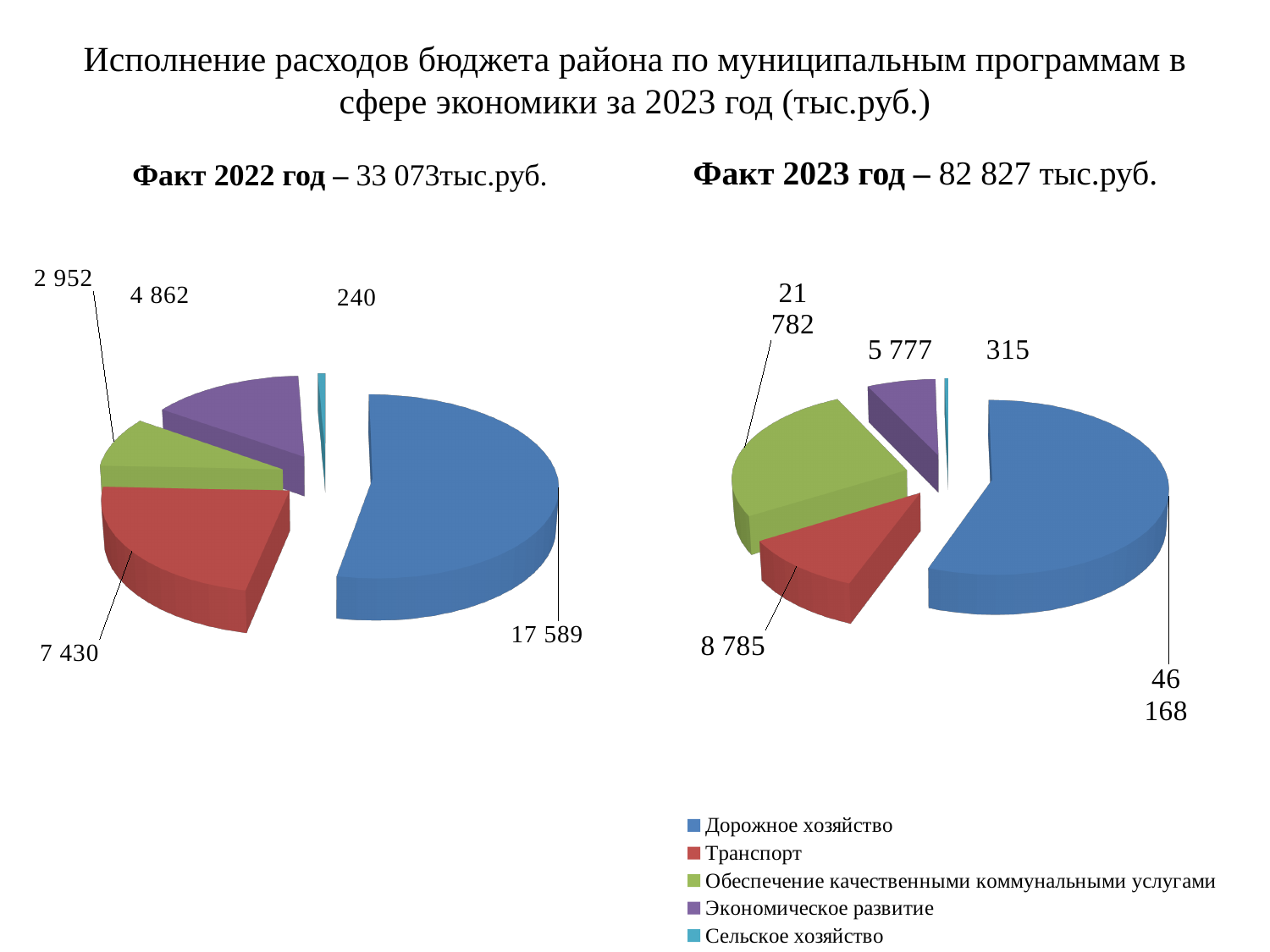
In the 2023 pie chart (Факт 2023 год), what is the value for Сельское хозяйство? 315 In the 2023 pie chart (Факт 2023 год), which category has the largest slice? Дорожное хозяйство What is the difference between the Дорожное хозяйство value in the 2023 chart and the Дорожное хозяйство value in the 2022 chart? 28 579 What colour represents Экономическое развитие in the legend? Purple What type of chart is used on this slide? Pie chart How many categories does the legend list? 5 In the 2022 pie chart (Факт 2022 год), what is the value for Транспорт? 7 430 In the 2023 pie chart (Факт 2023 год), what is the difference between Дорожное хозяйство and Обеспечение качественными коммунальными услугами? 24 386 In the 2022 pie chart (Факт 2022 год), which category has the smallest slice? Сельское хозяйство In the 2022 pie chart (Факт 2022 год), which is larger: Транспорт or Экономическое развитие? Транспорт In the 2023 pie chart (Факт 2023 год), what is the value for Обеспечение качественными коммунальными услугами? 21 782 In the 2022 pie chart (Факт 2022 год), what is the value for Дорожное хозяйство? 17 589